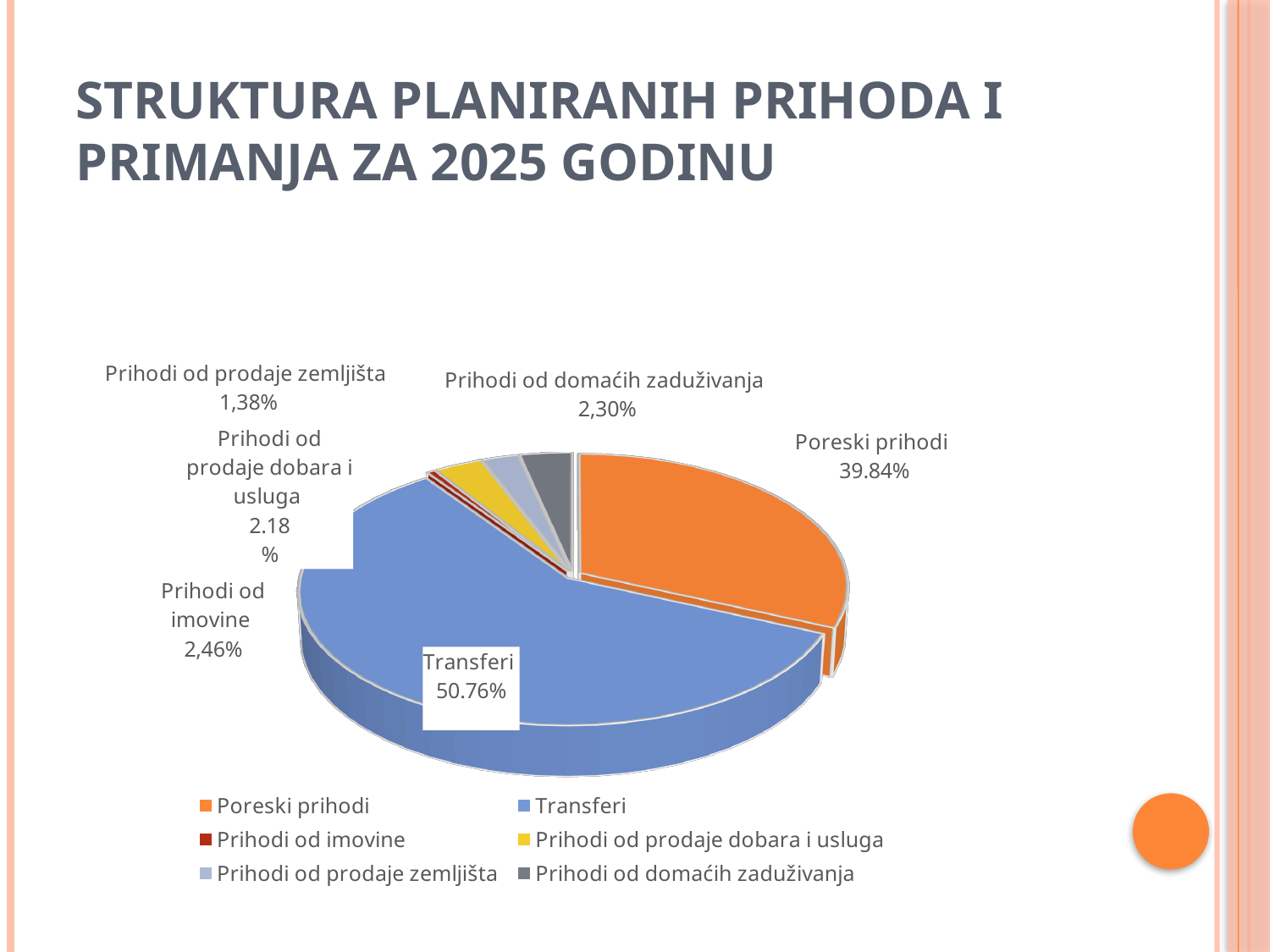
What is the value shown for Prihodi od imovine? 2,46% What share of the pie does Poreski prihodi have? 39.84% What is the value shown for Prihodi od domaćih zaduživanja? 2,30% What is the difference between the shares of Transferi and Poreski prihodi? 10.92% Which category has the largest slice of the pie? Transferi How many categories does the legend list? 6 What share of the pie does Transferi have? 50.76% What is the value shown for Prihodi od prodaje zemljišta? 1,38% What type of chart is shown on the slide? pie chart What is the title of the slide containing the chart? STRUKTURA PLANIRANIH PRIHODA I PRIMANJA ZA 2025 GODINU